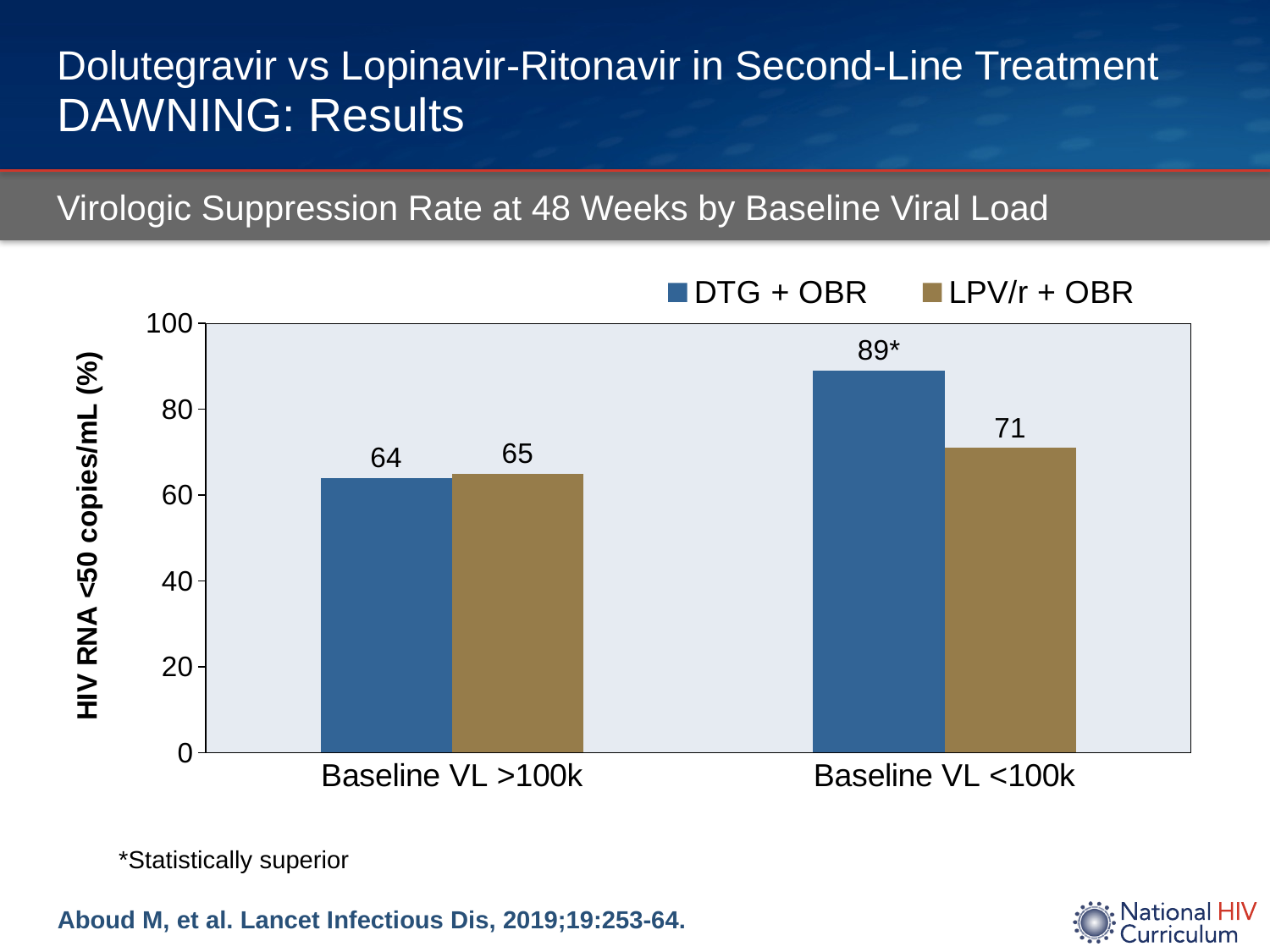
What is the difference between DTG + OBR and LPV/r + OBR in the Baseline VL <100k group? 18 How many baseline viral load categories are shown on the x axis? 2 Is the value for LPV/r + OBR in the Baseline VL >100k group greater or less than 80? less Which bar has the highest value on the chart? DTG + OBR, Baseline VL <100k What is the value for LPV/r + OBR in the Baseline VL >100k group? 65 What is the value shown for DTG + OBR in the Baseline VL <100k group? 89* What is the virologic suppression rate for LPV/r + OBR in the Baseline VL <100k group? 71 In the Baseline VL <100k group, which treatment has the higher suppression rate? DTG + OBR What kind of chart is shown on the slide? Bar chart How many series does the legend list? 2 What is the virologic suppression rate for DTG + OBR in the Baseline VL >100k group? 64 What is the label of the y axis? HIV RNA <50 copies/mL (%)